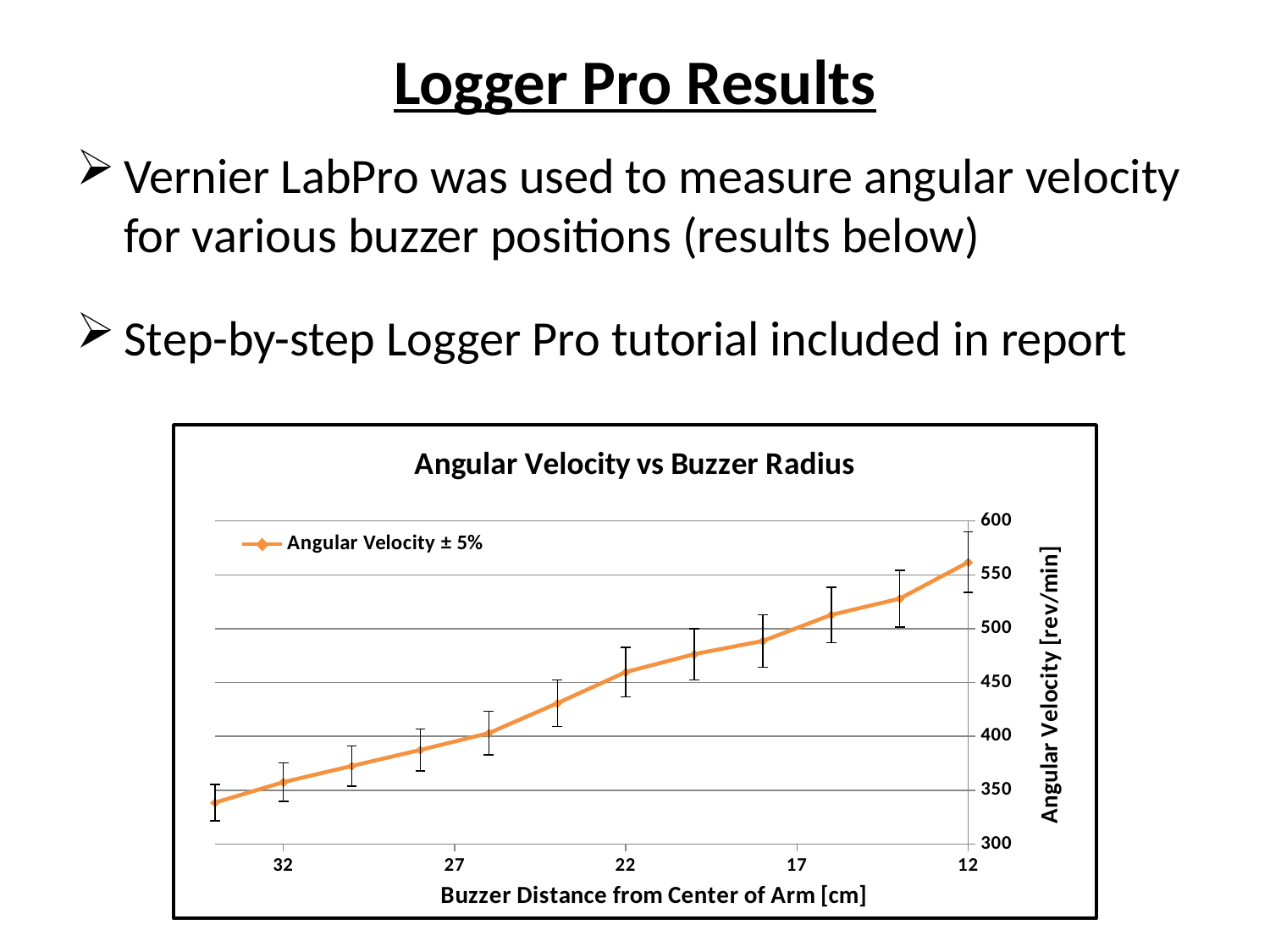
What is the title of the chart? Angular Velocity vs Buzzer Radius Is the angular velocity at a buzzer distance of 22 cm greater or less than 450? greater Which has the larger angular velocity, a buzzer distance of 12 cm or 32 cm? 12 cm Is the angular velocity at a buzzer distance of 32 cm greater or less than 400? less What is the label of the series in the legend? Angular Velocity ± 5% At which labeled buzzer distance on the x axis is the angular velocity highest? 12 Is the angular velocity at a buzzer distance of 27 cm greater or less than 450? less How many series does the chart legend list? 1 Do the angular velocity values rise or fall moving from left to right along the x axis? rise What kind of chart is shown on the slide? line chart